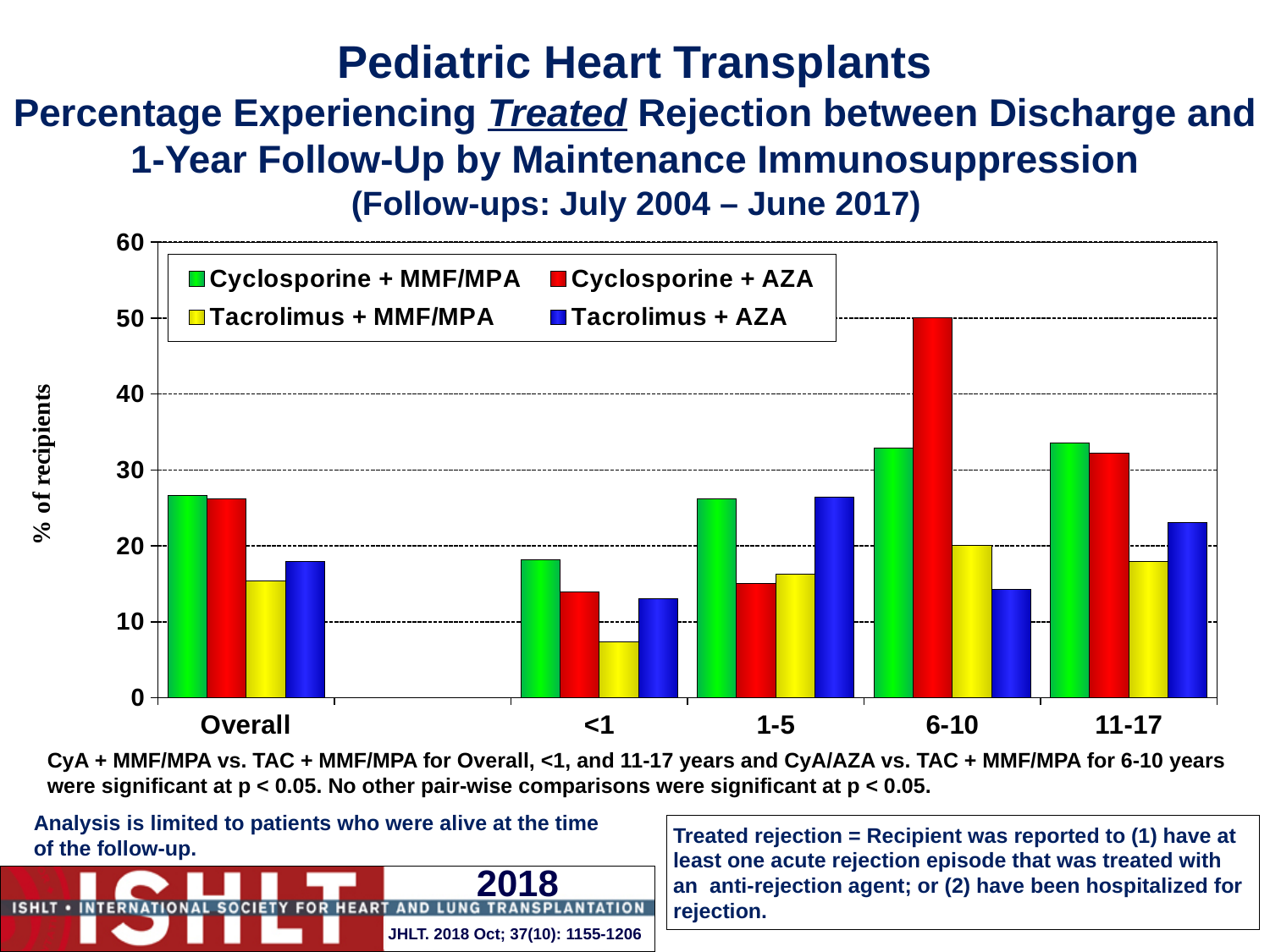
How many age-group categories are shown on the x axis? 4 Which series has the lowest value in the <1 age group? Tacrolimus + MMF/MPA In the Overall category, which is larger: Cyclosporine + MMF/MPA or Tacrolimus + MMF/MPA? Cyclosporine + MMF/MPA What kind of chart is shown on the slide? bar chart Is the Tacrolimus + MMF/MPA value for the <1 age group greater or less than 10? less In the 6-10 age group, which is larger: Cyclosporine + AZA or Tacrolimus + AZA? Cyclosporine + AZA What colour represents Tacrolimus + AZA in the legend? blue For which age group is the Cyclosporine + AZA value highest? 6-10 Is the Cyclosporine + MMF/MPA value for the 11-17 age group greater or less than 30? greater What is the label on the y axis? % of recipients Is the Cyclosporine + AZA value for the 6-10 age group greater or less than 40? greater How many series does the legend list? 4